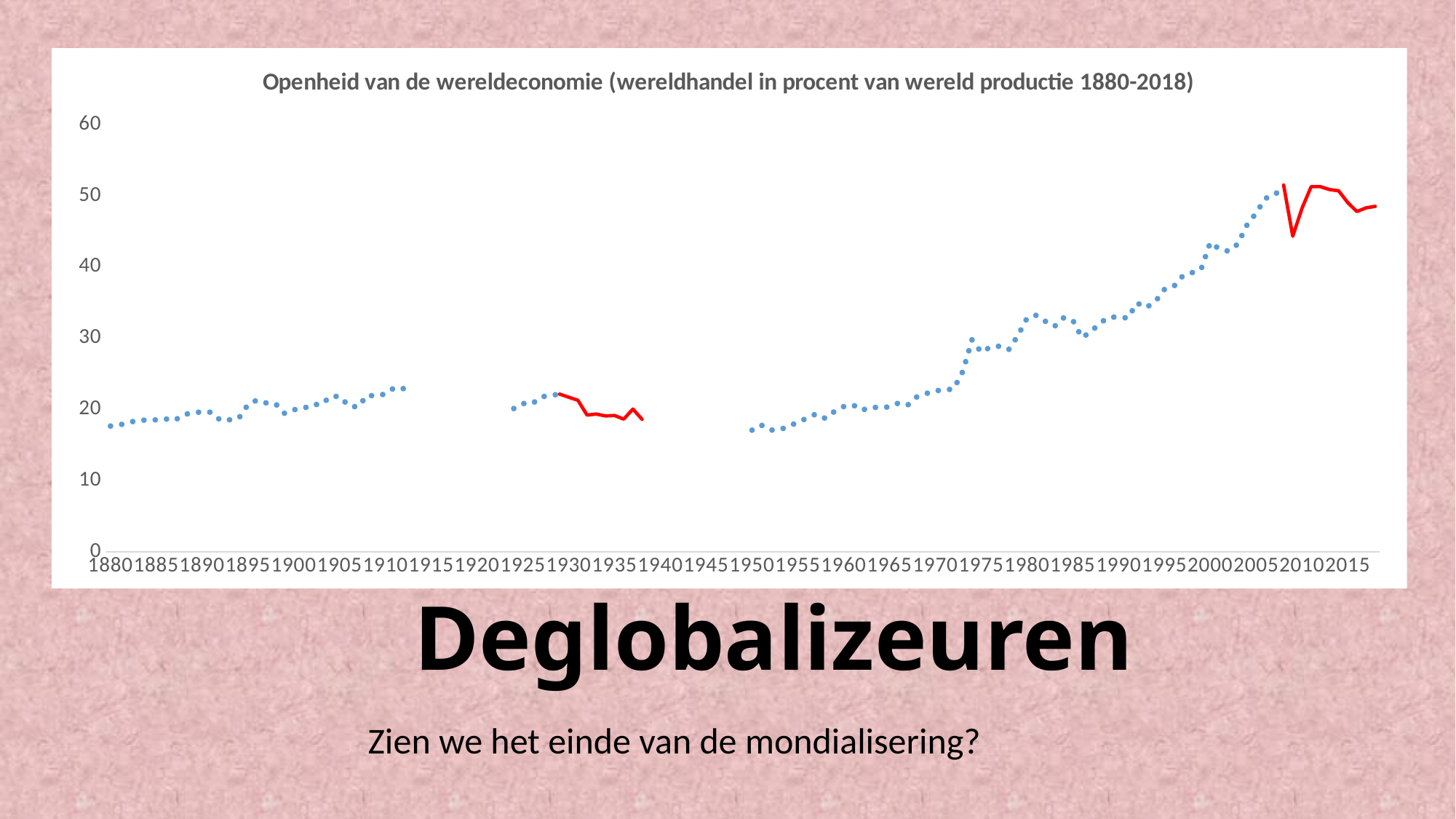
In which period does the chart reach its highest value: around 1910, around 1930, or around 2008? around 2008 Do the values generally rise or fall between 1950 and 2005? rise Is the value for 1980 greater or less than 30? greater What is the title of the chart? Openheid van de wereldeconomie (wereldhandel in procent van wereld productie 1880-2018) Which year has the larger value, 1880 or 2015? 2015 Is the value for 1950 greater or less than 20? less What is the highest value shown on the vertical axis of the chart? 60 Is the value for 2000 greater or less than 40? greater Do the values rise or fall along the red segment between 1930 and 1938? fall Which year has the larger value, 1910 or 1950? 1910